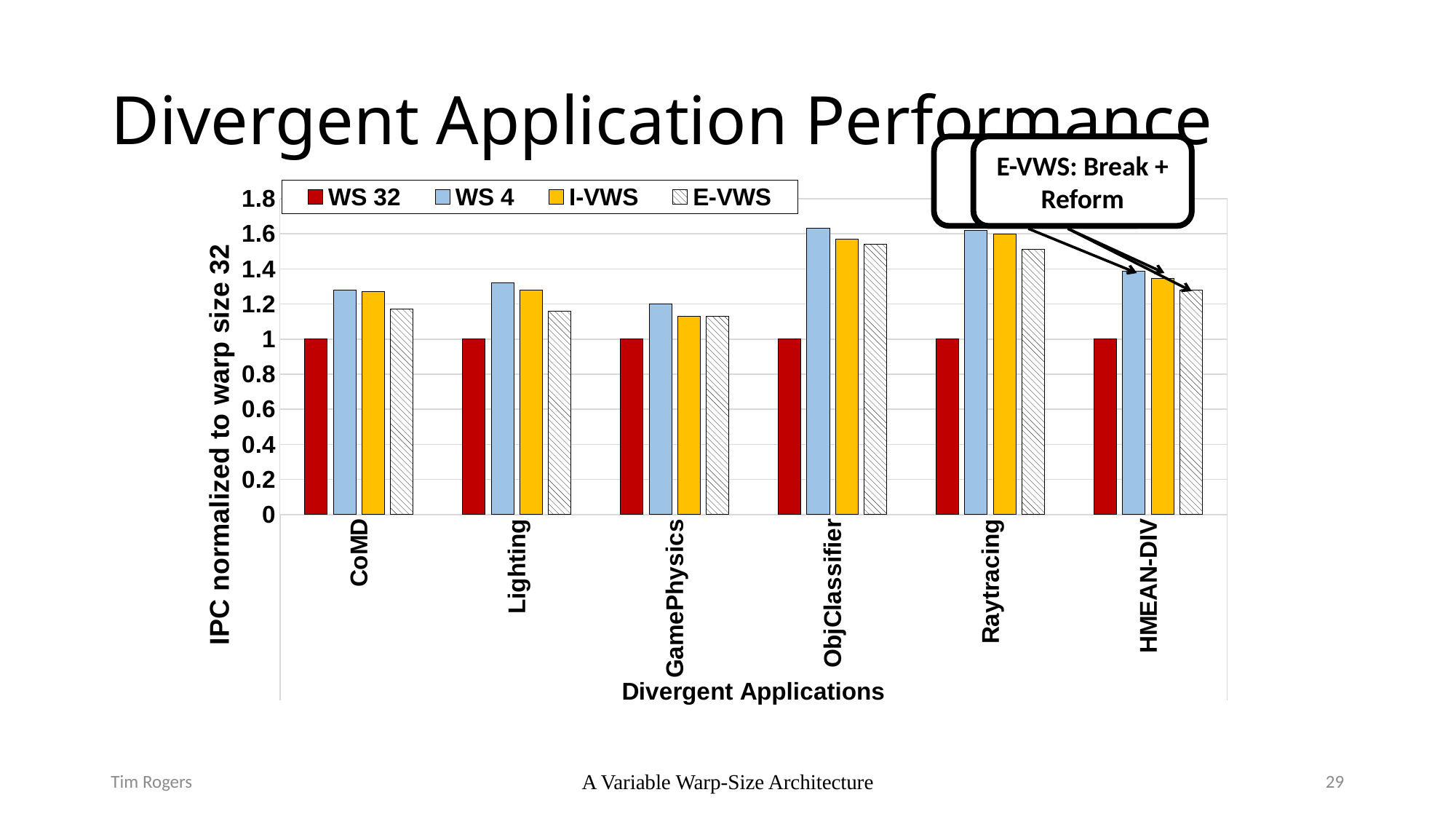
Is the E-VWS value for Lighting greater or less than 1.4? less Which application has the lowest I-VWS value? GamePhysics How many series does the chart's legend list? 4 Is the WS 4 value for ObjClassifier greater or less than 1.4? greater How many divergent applications are shown on the x axis of the chart? 6 What is the normalized IPC value of WS 32 for CoMD? 1 What does the callout box on the chart say? E-VWS: Break + Reform For Lighting, which is larger: the WS 4 value or the E-VWS value? WS 4 What kind of chart is shown on the slide? bar chart What is the title of the chart's y axis? IPC normalized to warp size 32 Is the WS 4 value for HMEAN-DIV greater or less than 1.2? greater For ObjClassifier, which is larger: the WS 4 value or the E-VWS value? WS 4